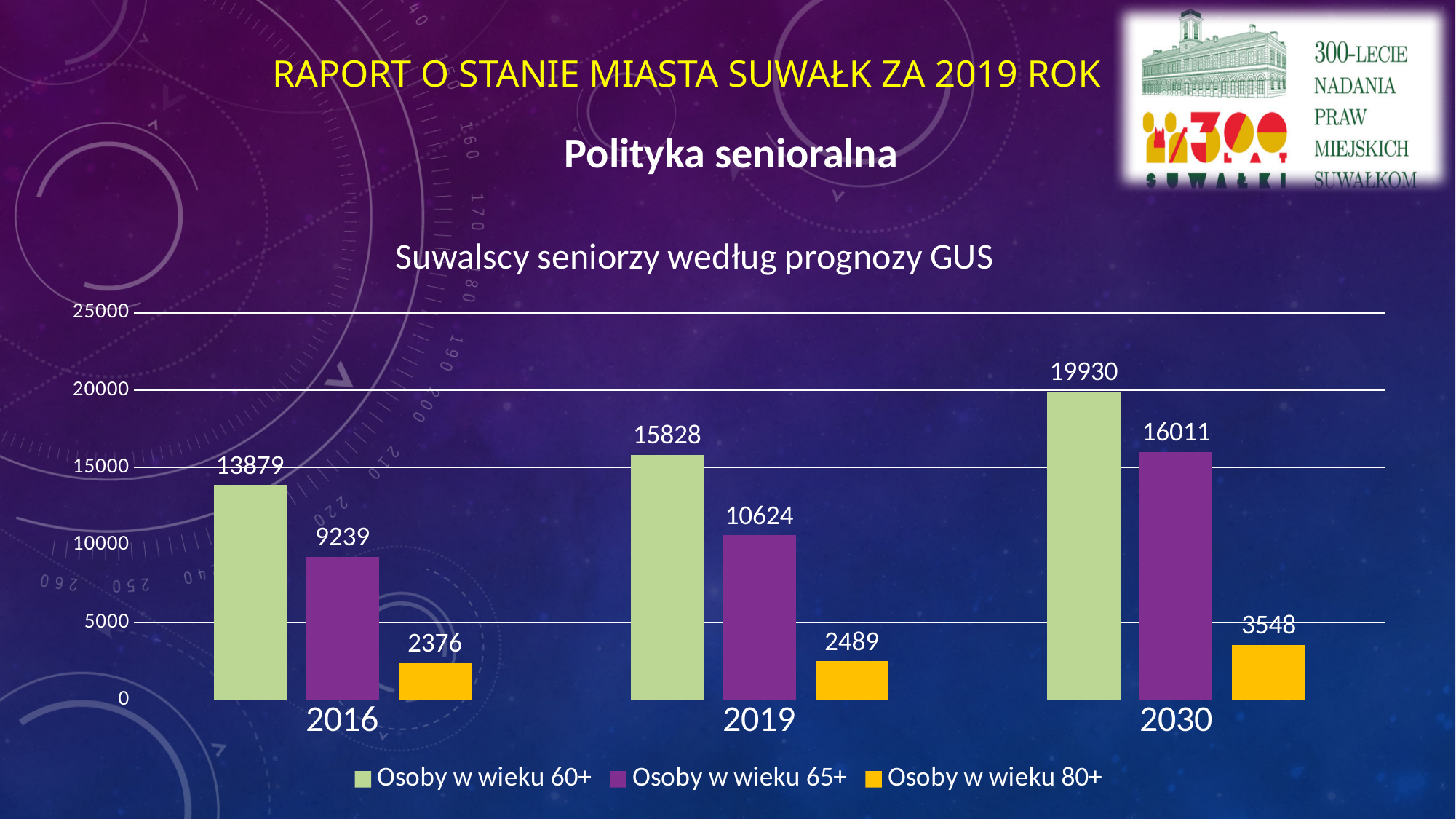
In which year is the value for Osoby w wieku 60+ highest? 2030 What kind of chart is shown on the slide? bar chart What is the value for Osoby w wieku 60+ in 2016? 13879 What is the value for Osoby w wieku 65+ in 2030? 16011 What is the difference between the Osoby w wieku 60+ values for 2030 and 2019? 4102 In which year is the value for Osoby w wieku 80+ lowest? 2016 What is the title of the chart? Suwalscy seniorzy według prognozy GUS Is the value for Osoby w wieku 65+ in 2016 greater or less than 10000? less How many series does the legend list? 3 What is the value for Osoby w wieku 80+ in 2019? 2489 Which is larger: Osoby w wieku 65+ in 2019 or Osoby w wieku 60+ in 2016? Osoby w wieku 60+ in 2016 How many years are shown on the x axis? 3